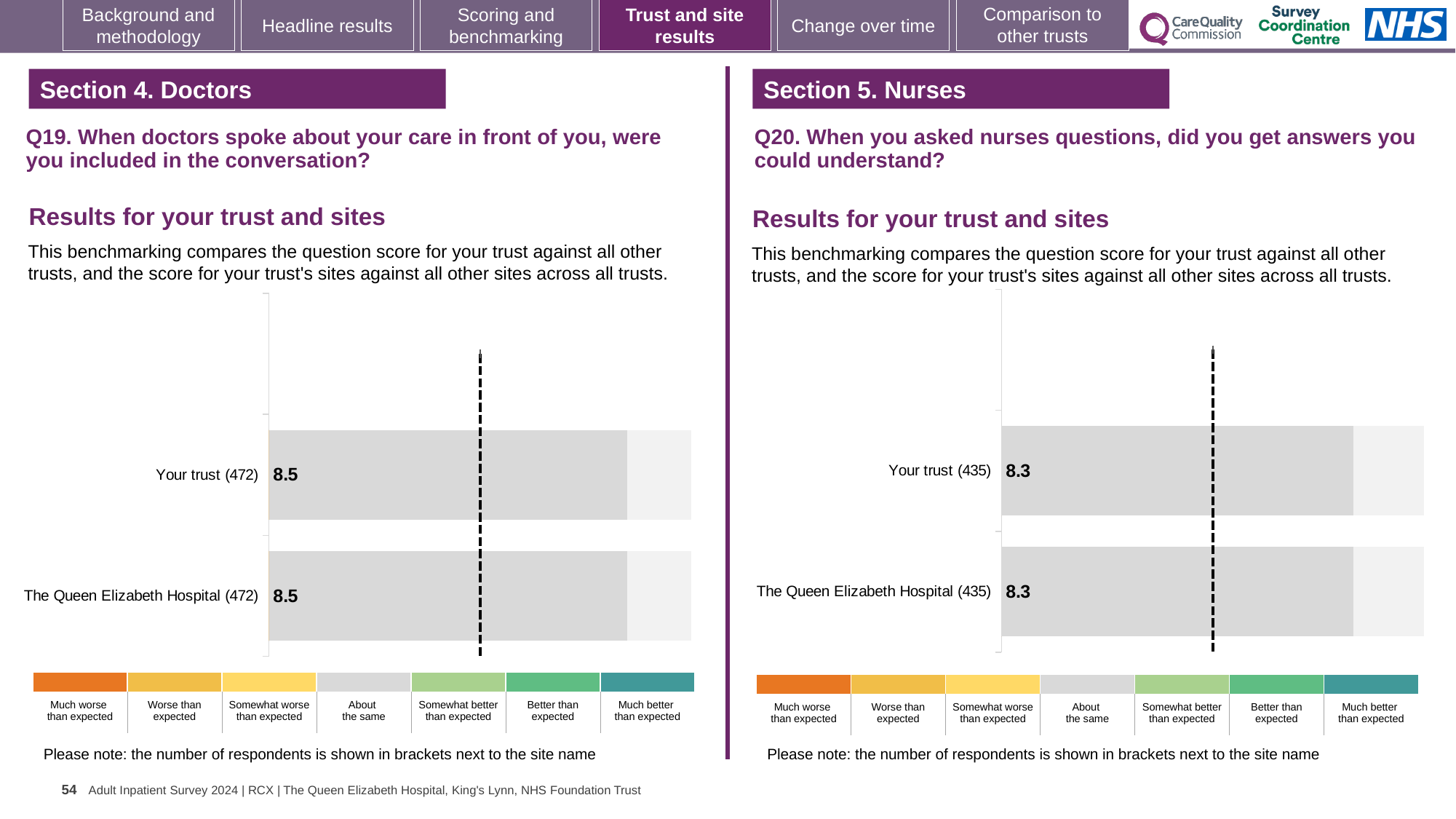
How many bars are plotted on the Q19 chart (left)? 2 On the Q19 chart (left), what is the score for The Queen Elizabeth Hospital? 8.5 On the Q20 chart (right), what is the score for The Queen Elizabeth Hospital? 8.3 On the Q20 chart (right), what is the score for Your trust? 8.3 On the Q20 chart (right), what is the difference between the score for Your trust and the score for The Queen Elizabeth Hospital? 0 On the Q19 chart (left), which benchmark category does the grey colour of the bars correspond to in the legend? About the same On the Q20 chart (right), how many respondents are shown in brackets for The Queen Elizabeth Hospital? 435 On the Q19 chart (left), how many respondents are shown in brackets for Your trust? 472 On the Q19 chart (left), what is the score for Your trust? 8.5 How many bars are plotted on the Q20 chart (right)? 2 On the Q19 chart (left), what is the difference between the score for Your trust and the score for The Queen Elizabeth Hospital? 0 What kind of chart is the Q20 chart (right)? Bar chart